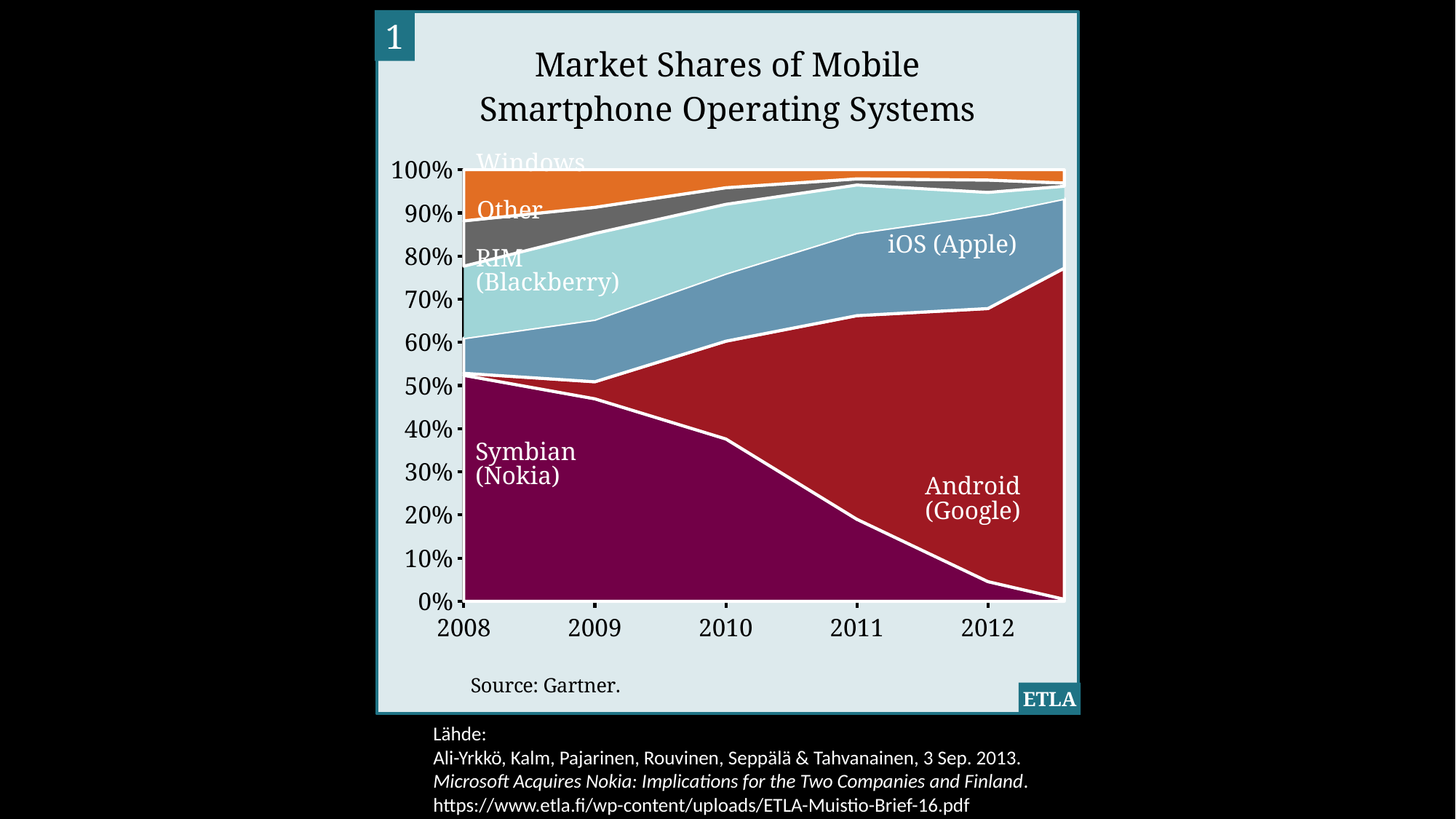
What kind of chart is shown on the slide? Stacked area chart Is the market share of Symbian (Nokia) in 2008 greater or less than 50%? greater Which has the larger market share in 2012, Symbian (Nokia) or Android (Google)? Android (Google) What is the title of the chart? Market Shares of Mobile Smartphone Operating Systems Is the market share of Symbian (Nokia) in 2012 greater or less than 10%? less What source is cited below the chart? Gartner Is the market share of Android (Google) in 2012 greater or less than 50%? greater Does the market share of Android (Google) rise or fall from 2008 to 2012? Rise How many operating system series are labelled in the chart? 6 How many years are labelled on the x axis? 5 Does the market share of Symbian (Nokia) rise or fall from 2008 to 2012? Fall